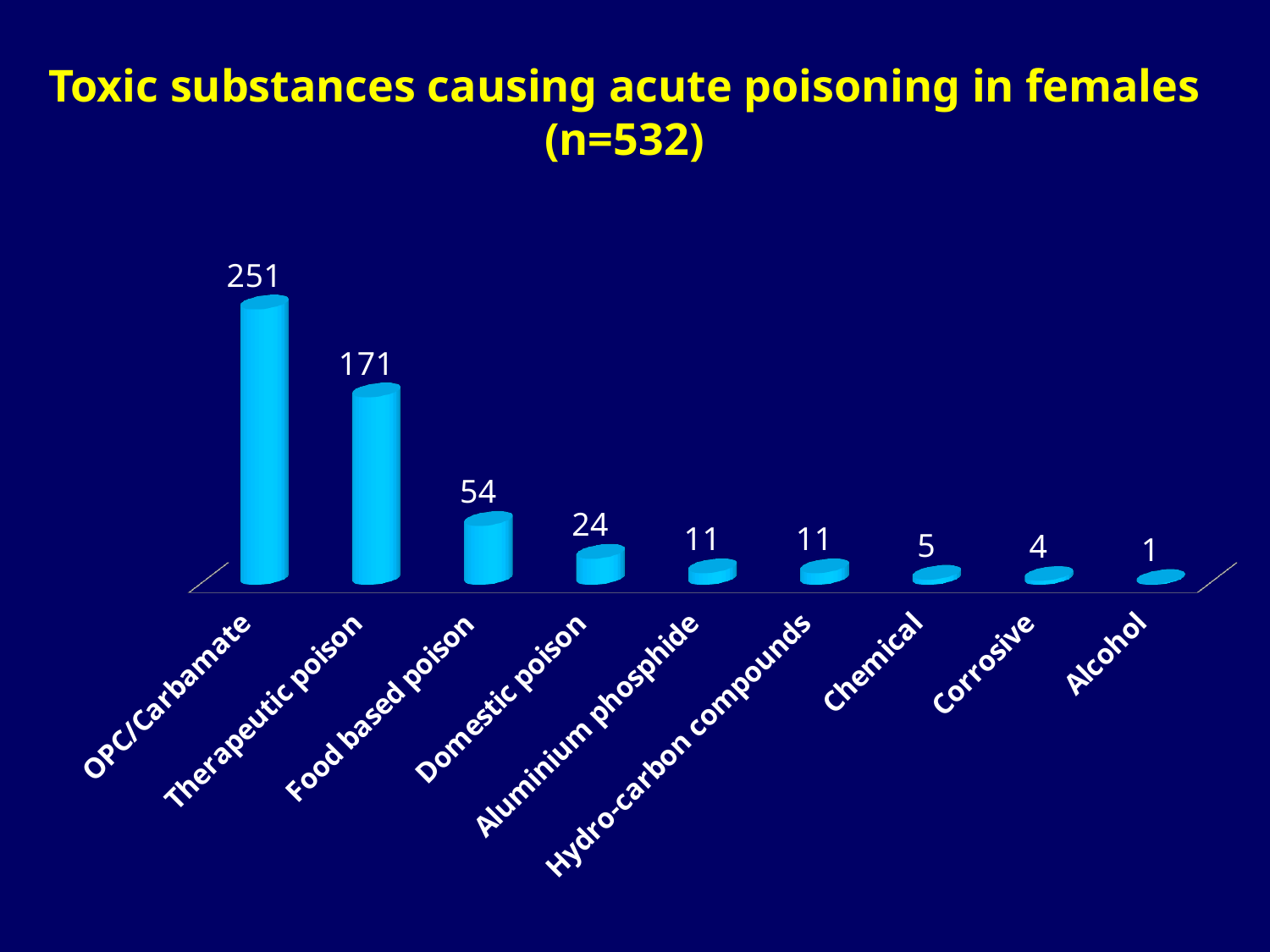
What is the difference between the values for OPC/Carbamate and Therapeutic poison? 80 Which is larger, the value for Food based poison or the value for Domestic poison? Food based poison What is the value for Food based poison? 54 What is the value for OPC/Carbamate? 251 How many categories are shown on the chart? 9 What is the value for Chemical? 5 What is the value for Therapeutic poison? 171 Which category has the lowest value? Alcohol What is the title of the chart? Toxic substances causing acute poisoning in females (n=532) What kind of chart is shown on the slide? Bar chart What is the value for Domestic poison? 24 Which category has the highest value? OPC/Carbamate